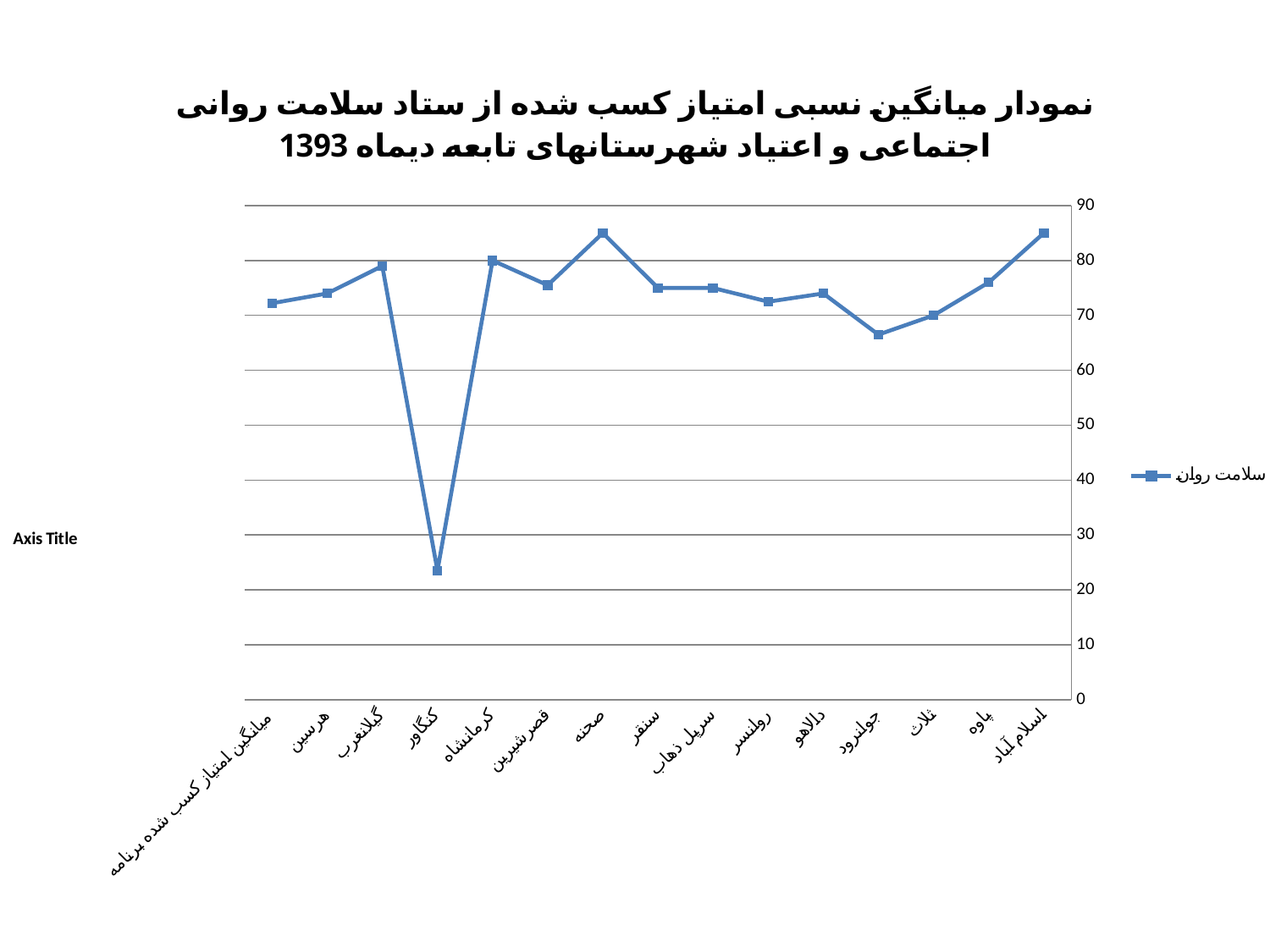
How many categories are plotted along the x axis? 15 What is the highest value shown on the vertical axis? 90 Is the value for صحنه greater or less than 80? greater Which category has the lowest value? کنگاور Is the value for گیلانغرب greater or less than 70? greater What is the name of the series shown in the legend? سلامت روان Is the value for کنگاور greater or less than 30? less What kind of chart is shown on the slide? line chart Which has the larger value, جوانرود or صحنه? صحنه Which has the larger value, کنگاور or کرمانشاه? کرمانشاه How many series does the legend list? 1